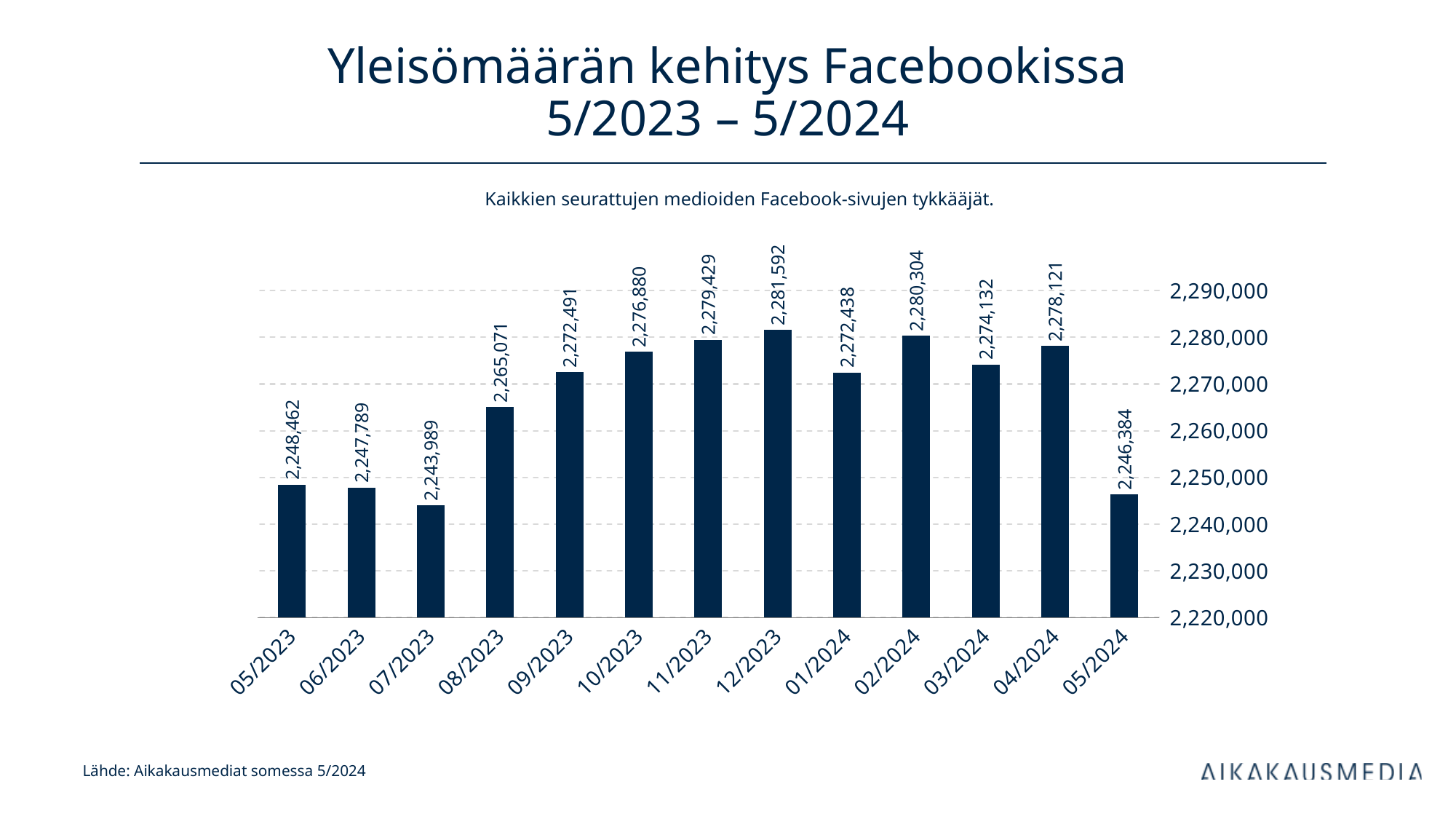
Which is larger, the value for 01/2024 or the value for 08/2023? 01/2024 What is the value for 08/2023? 2,265,071 What is the title of the chart? Yleisömäärän kehitys Facebookissa 5/2023 – 5/2024 What is the difference between the values for 12/2023 and 07/2023? 37,603 Is the value for 10/2023 greater or less than 2,270,000? greater What is the difference between the values for 05/2023 and 05/2024? 2,078 Which month has the highest value? 12/2023 Which month has the lowest value? 07/2023 What is the value for 12/2023? 2,281,592 What is the value for 05/2024? 2,246,384 What kind of chart is shown on the slide? bar chart How many months are shown on the x axis? 13